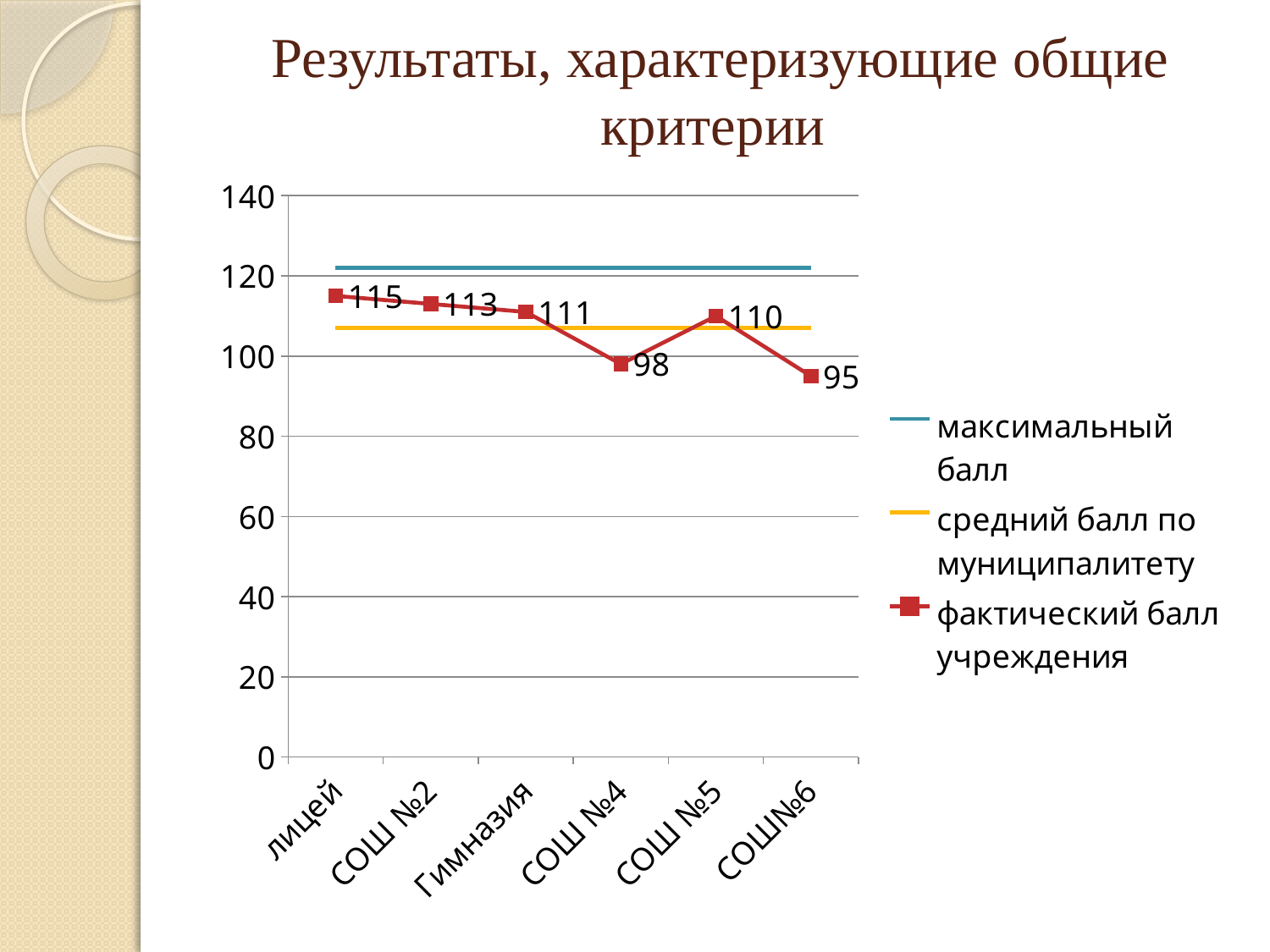
What kind of chart is shown on the slide? line chart Which institution has the lowest фактический балл учреждения? СОШ№6 How many institutions are shown on the x axis? 6 What is the difference between the фактический балл учреждения for лицей and for СОШ№6? 20 What is the фактический балл учреждения for СОШ №4? 98 How many series does the legend list? 3 What is the фактический балл учреждения for лицей? 115 Is the максимальный балл line greater or less than 120? greater What is the фактический балл учреждения for СОШ №5? 110 Which has a higher фактический балл учреждения, Гимназия or СОШ №4? Гимназия Which institution has the highest фактический балл учреждения? лицей Is the средний балл по муниципалитету line greater or less than 100? greater